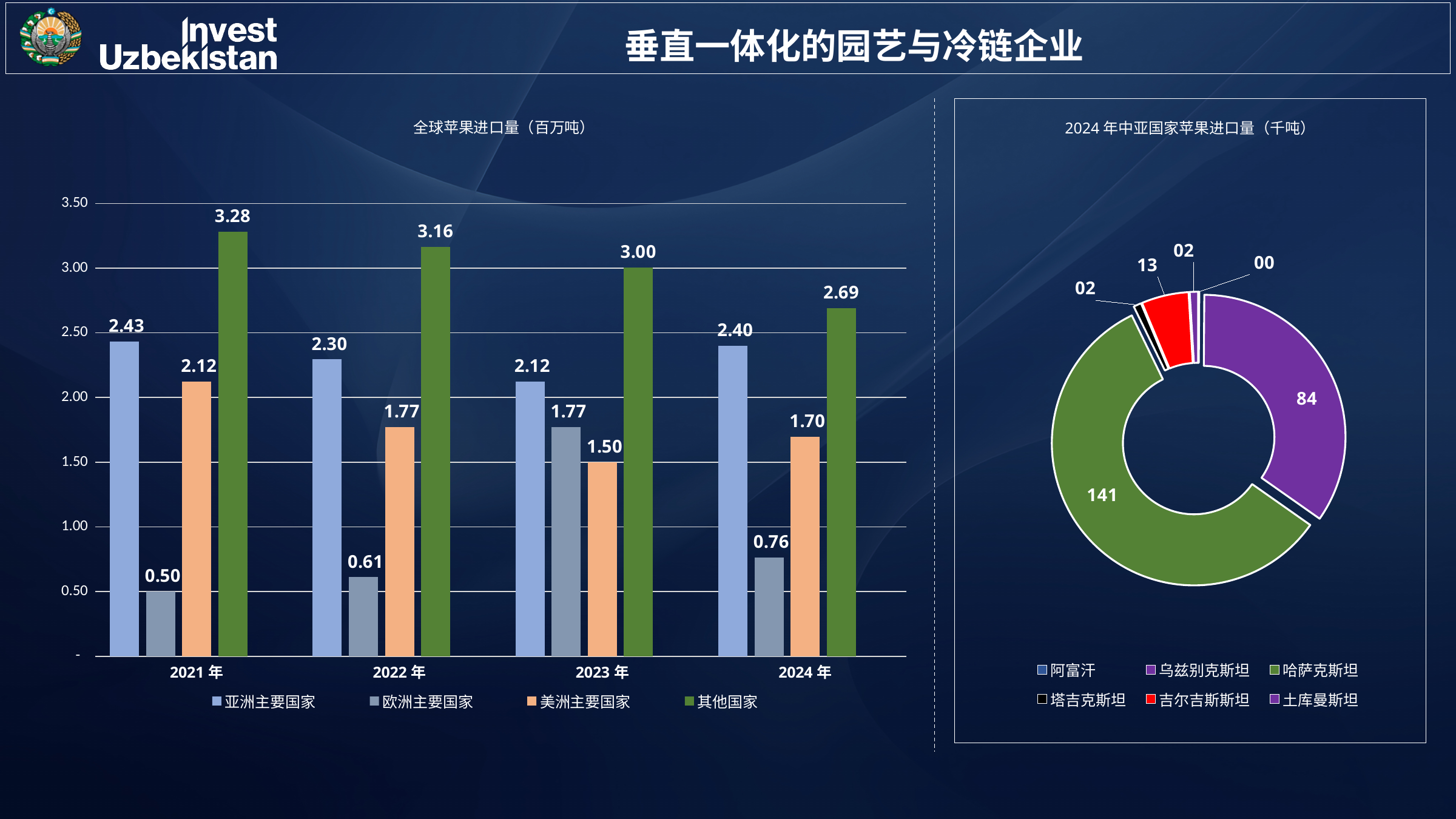
In the chart titled 全球苹果进口量（百万吨）, what is the value for 欧洲主要国家 in 2023 年? 1.77 In the chart titled 全球苹果进口量（百万吨）, which year has the lowest value for 欧洲主要国家? 2021 年 How many entries does the legend of the chart titled 2024 年中亚国家苹果进口量（千吨） list? 6 In the chart titled 全球苹果进口量（百万吨）, what is the difference between 其他国家 and 亚洲主要国家 in 2024 年? 0.29 What kind of chart is the chart titled 全球苹果进口量（百万吨）? bar chart In the chart titled 2024 年中亚国家苹果进口量（千吨）, what is the value for 哈萨克斯坦? 141 In the chart titled 全球苹果进口量（百万吨）, what is the value for 其他国家 in 2021 年? 3.28 How many series does the legend of the chart titled 全球苹果进口量（百万吨） list? 4 In the chart titled 2024 年中亚国家苹果进口量（千吨）, which country has the largest slice? 哈萨克斯坦 In the chart titled 全球苹果进口量（百万吨）, what is the value for 美洲主要国家 in 2024 年? 1.70 In the chart titled 全球苹果进口量（百万吨）, which is larger in 2022 年: 亚洲主要国家 or 美洲主要国家? 亚洲主要国家 In the chart titled 全球苹果进口量（百万吨）, do the values for 其他国家 rise or fall from 2021 年 to 2024 年? fall